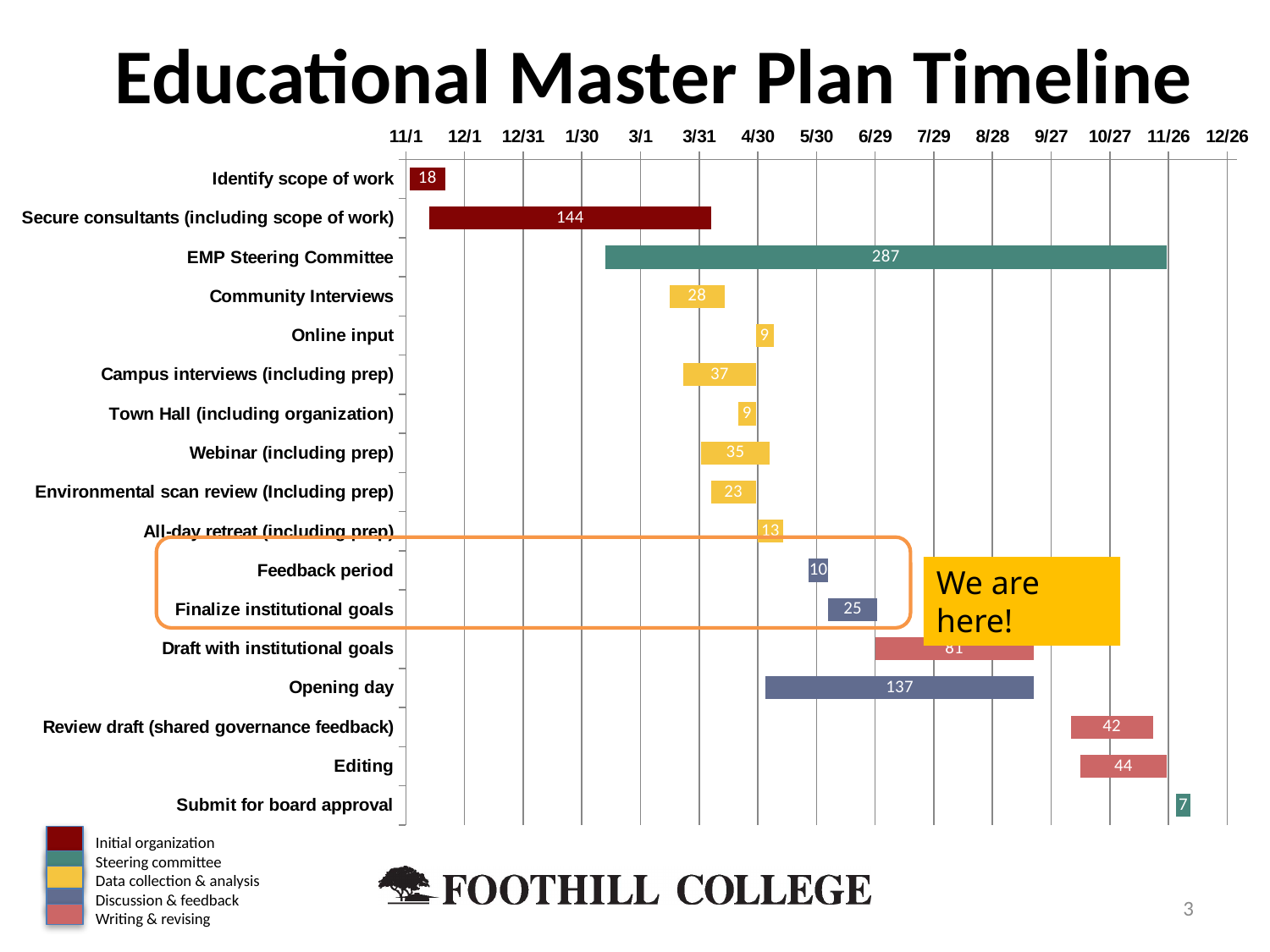
What is the duration label shown for EMP Steering Committee? 287 What value is labeled on the Editing bar? 44 What is the difference between the values for Editing and Review draft (shared governance feedback)? 2 Which task has the longest bar (highest value) in the chart? EMP Steering Committee What is the value shown for Opening day? 137 How many categories does the legend list? 5 How many tasks are listed on the vertical axis of the chart? 17 What type of chart is shown on the slide? Bar chart (Gantt chart) Which task has the smallest labeled value in the chart? Submit for board approval Which has a larger value, Campus interviews (including prep) or Webinar (including prep)? Campus interviews (including prep) What value is labeled on the Secure consultants (including scope of work) bar? 144 What is the difference between the values for Secure consultants (including scope of work) and Identify scope of work? 126